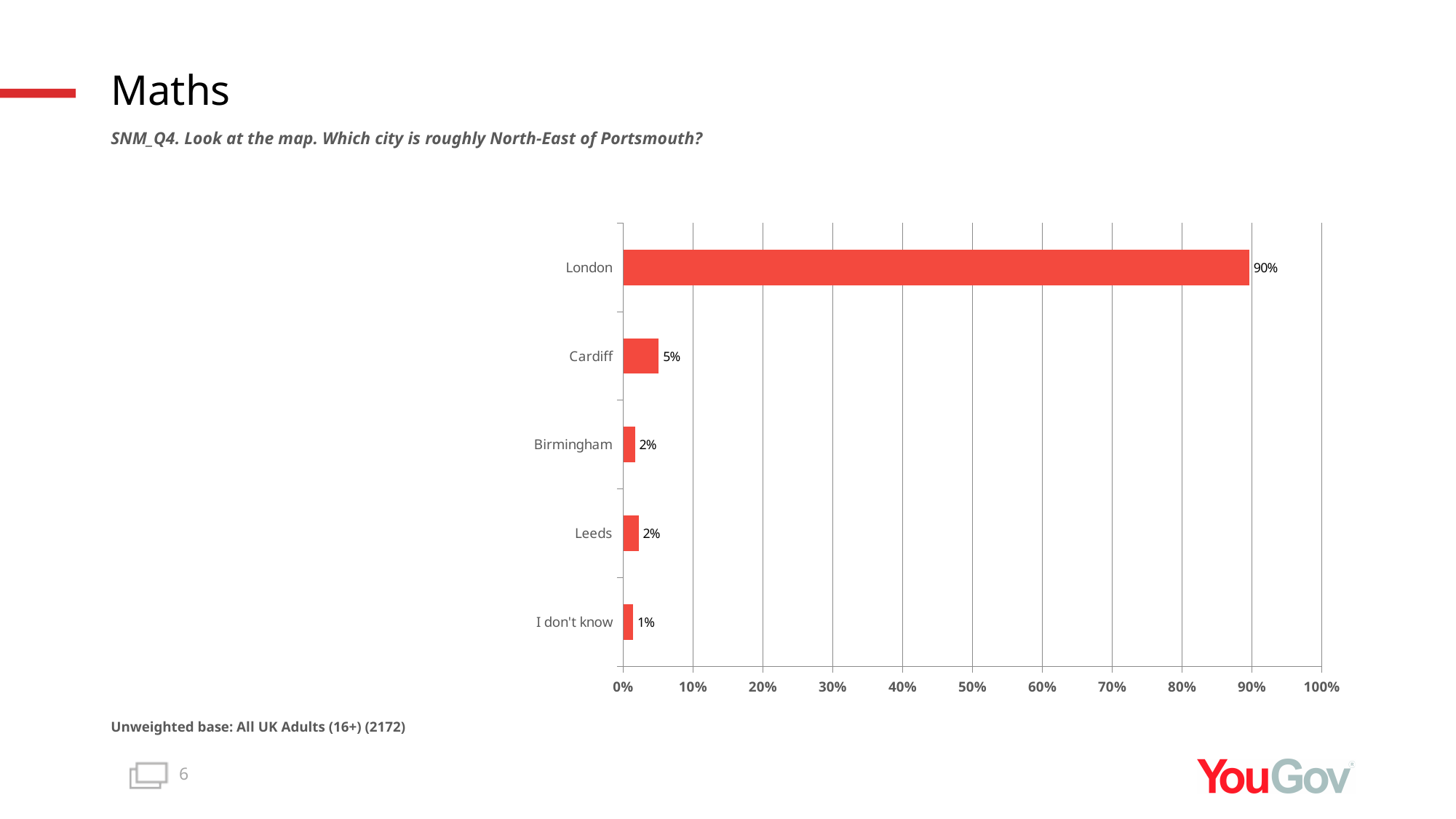
Is the value for London greater or less than 80%? greater How many categories are shown on the chart? 5 What is the value shown for Birmingham? 2% What kind of chart is shown on the slide? Bar chart What is the difference between the values for London and Cardiff? 85 percentage points What percentage of respondents answered London? 90% Which category has the highest value? London What is the value shown for 'I don't know'? 1% Which is larger, the value for Cardiff or the value for Leeds? Cardiff What is the unweighted base stated below the chart? All UK Adults (16+) (2172) What percentage of respondents answered Cardiff? 5% Which category has the lowest value? I don't know